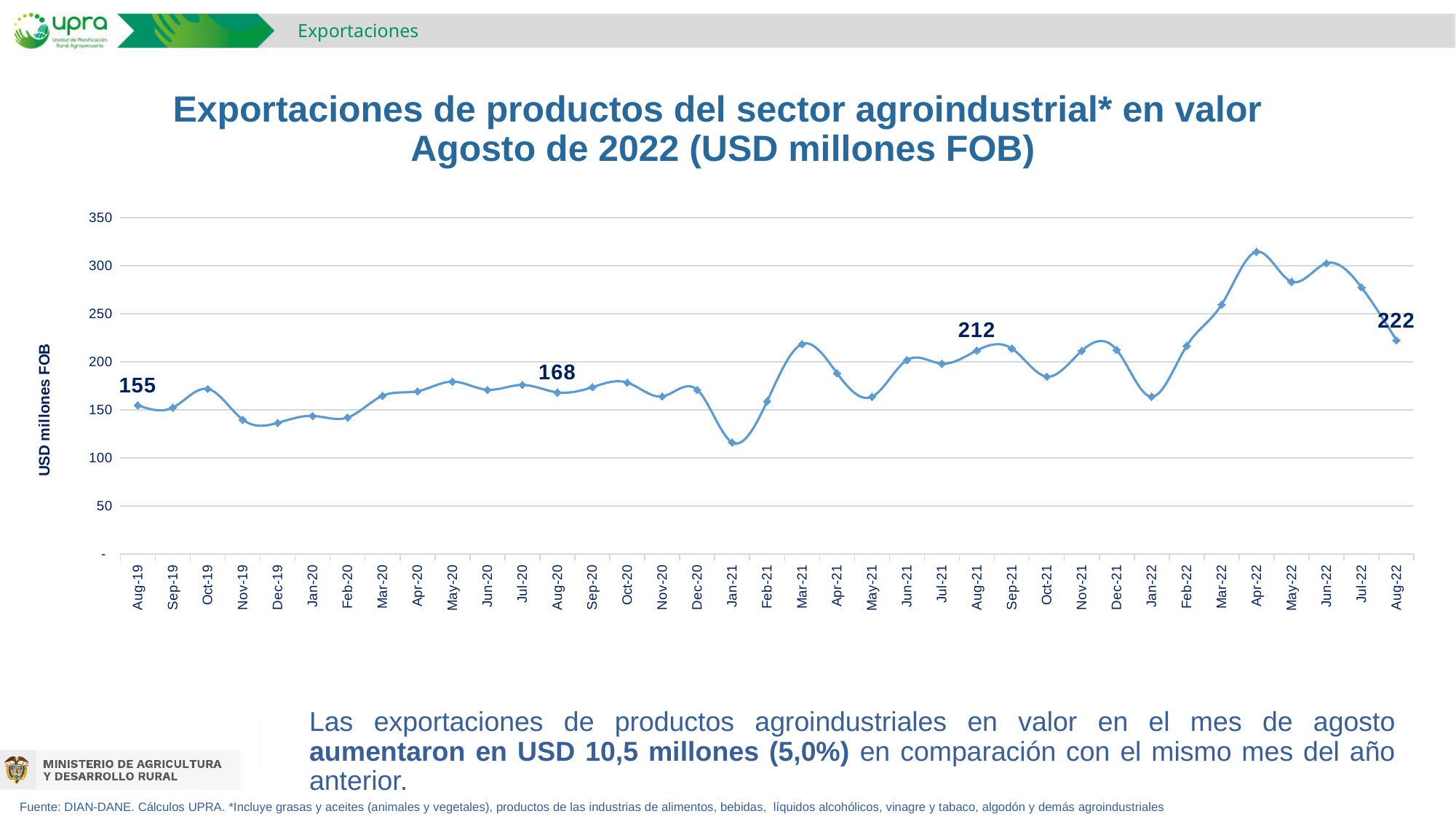
What is the value for Aug-19? 155 Is the value for Apr-22 greater or less than 300? greater Is the value for Jan-21 greater or less than 150? less What is the difference between the values for Aug-21 and Aug-20? 44 What is the difference between the values for Aug-22 and Aug-21? 10 What is the value for Aug-20? 168 Which is larger, the value for Aug-20 or the value for Aug-19? Aug-20 What kind of chart is shown on the slide? line chart Which month has the lowest value on the chart? Jan-21 What is the value for Aug-22? 222 Which month has the highest value on the chart? Apr-22 What is the value for Aug-21? 212